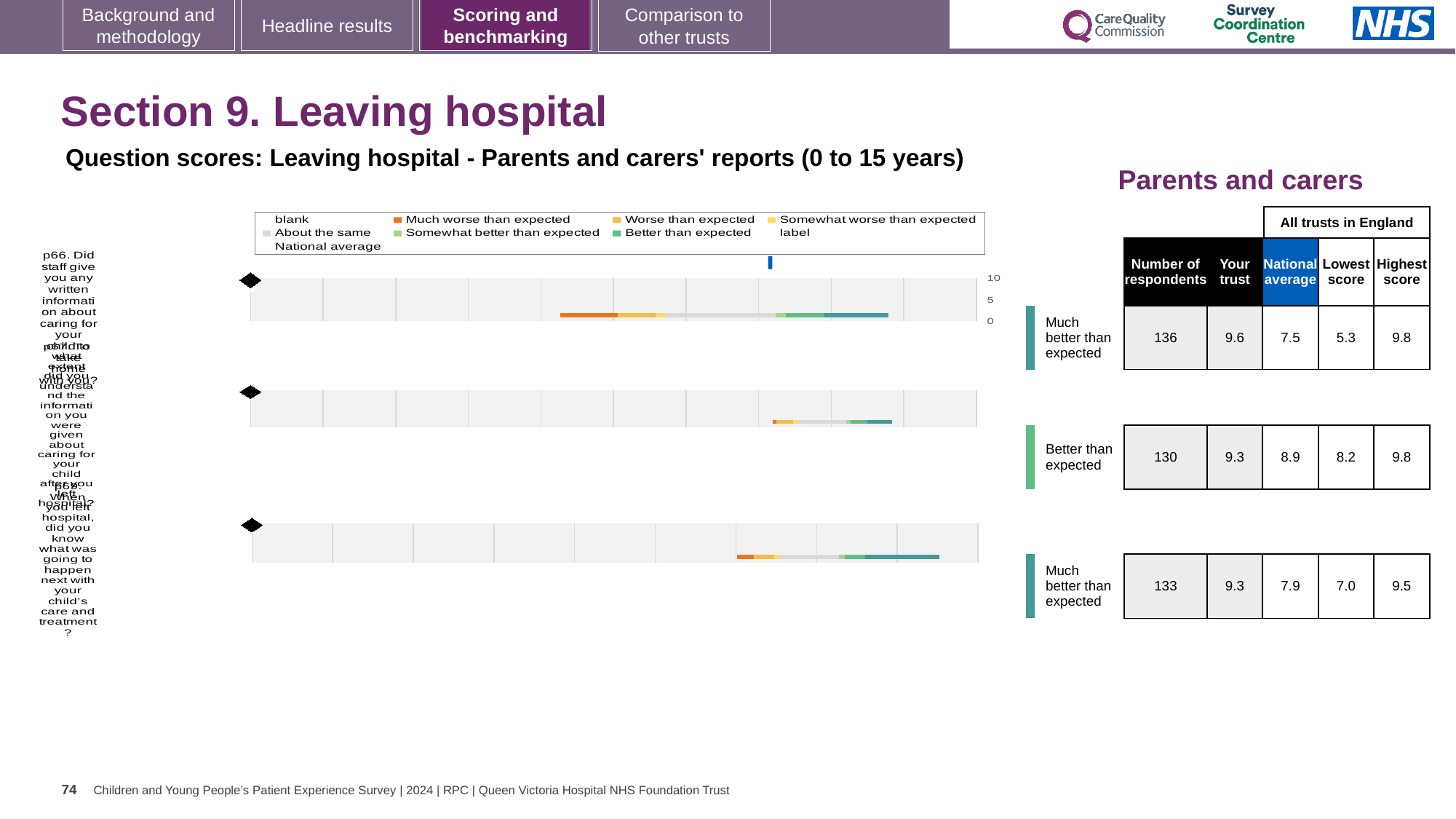
What benchmark rating is given to the middle question (p67)? Better than expected What is the highest score across all trusts in England for the bottom question (p68)? 9.5 What is the difference between the 'Your trust' score and the national average for the top question (p66)? 2.1 Which question has the highest 'Your trust' score? p66 (top question) What is the 'Your trust' score for the top question (p66)? 9.6 Is the 'Your trust' score for the middle question (p67) greater or less than 5? greater How many question score charts are shown on the slide? 3 Which is larger: the lowest score for the top question (p66) or the lowest score for the bottom question (p68)? bottom question (p68) In the chart legend, which colour represents 'Much worse than expected'? orange What kind of chart is used to show the question scores on this slide? bar chart How many respondents answered the bottom question (p68)? 133 What is the national average for the middle question (p67)? 8.9